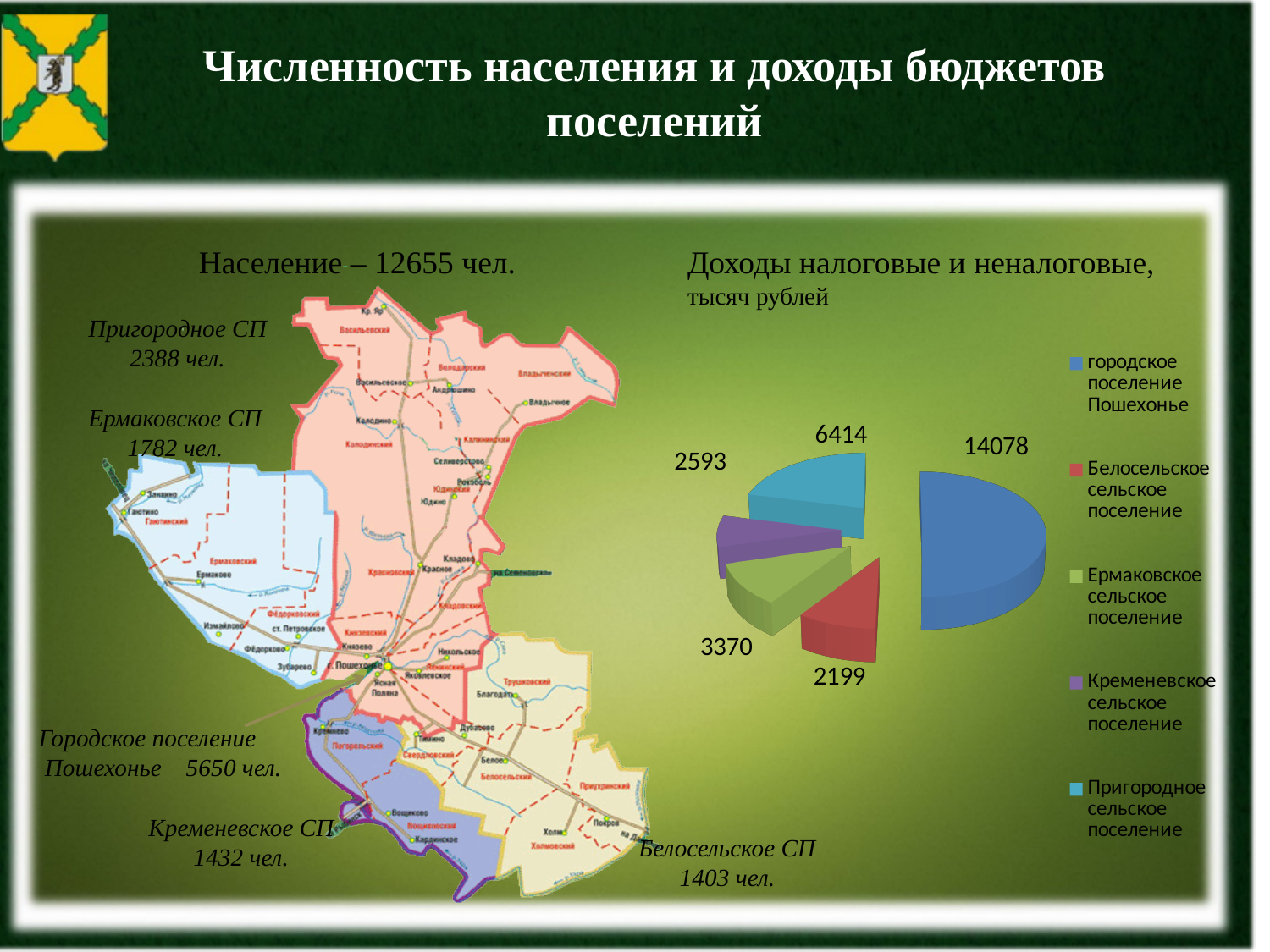
Which is larger in the pie chart: Ермаковское сельское поселение or Кременевское сельское поселение? Ермаковское сельское поселение What is the value for Белосельское сельское поселение in the pie chart? 2199 What is the value for Пригородное сельское поселение in the pie chart? 6414 What is the value for городское поселение Пошехонье in the pie chart? 14078 How many entries does the legend of the pie chart list? 5 What kind of chart is shown on the slide? pie chart What is the value for Ермаковское сельское поселение in the pie chart? 3370 What is the difference between the values for Пригородное сельское поселение and Кременевское сельское поселение? 3821 What is the title of the pie chart? Доходы налоговые и неналоговые, тысяч рублей How many slices does the pie chart have? 5 Which settlement has the largest slice in the pie chart? городское поселение Пошехонье